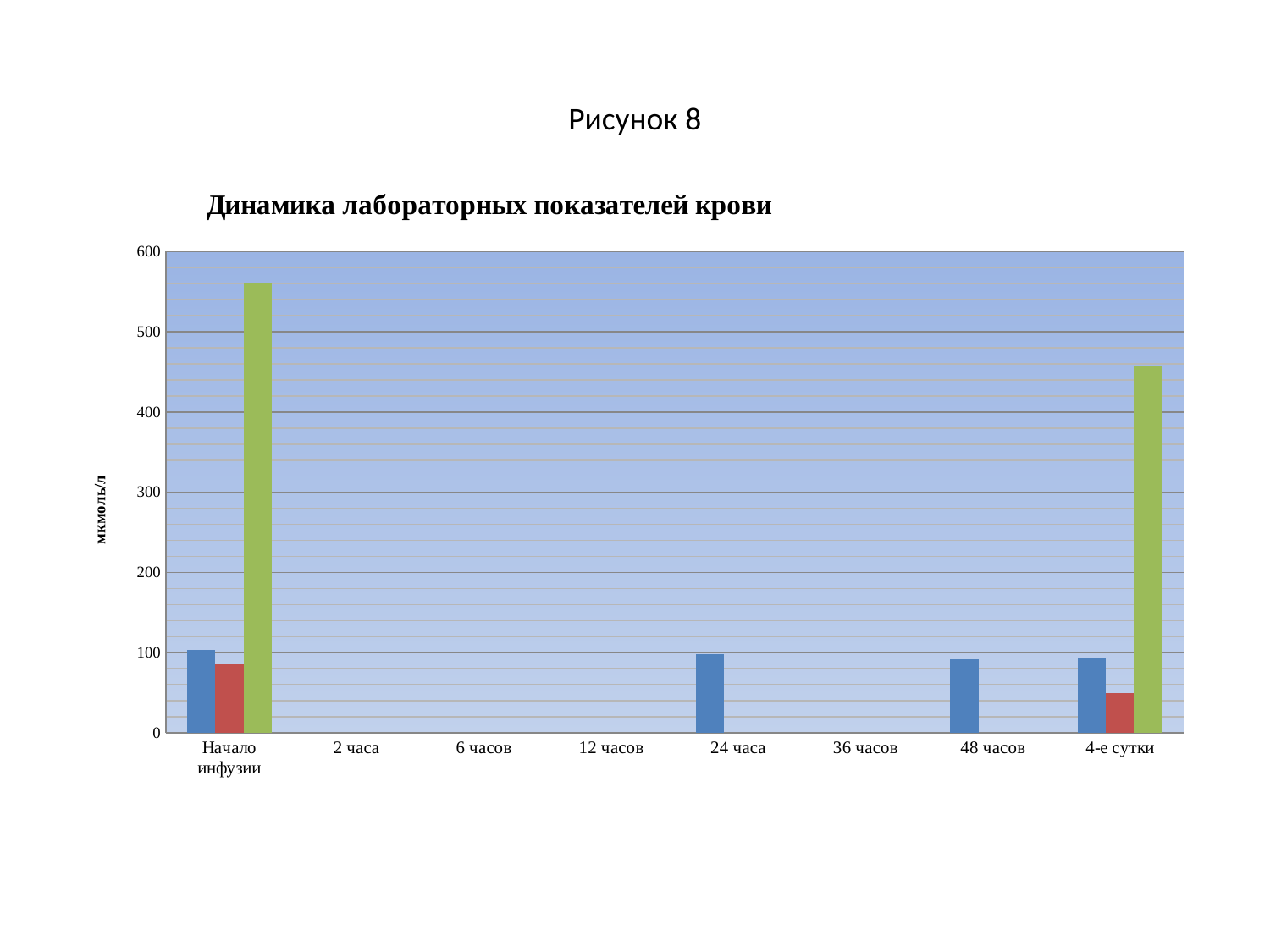
What unit is shown on the vertical axis of the chart? мкмоль/л How many categories are shown along the x axis of the chart? 8 Is the value of the green bar at 4-е сутки greater or less than 400? greater Is the value of the red bar at Начало инфузии greater or less than 100? less Is the value of the green bar at Начало инфузии greater or less than 500? greater Which category has the tallest bar in the chart? Начало инфузии Which is larger: the green bar at Начало инфузии or the green bar at 4-е сутки? Начало инфузии Which is larger: the red bar at Начало инфузии or the red bar at 4-е сутки? Начало инфузии What kind of chart is shown on the slide? bar chart What is the title of the chart? Динамика лабораторных показателей крови